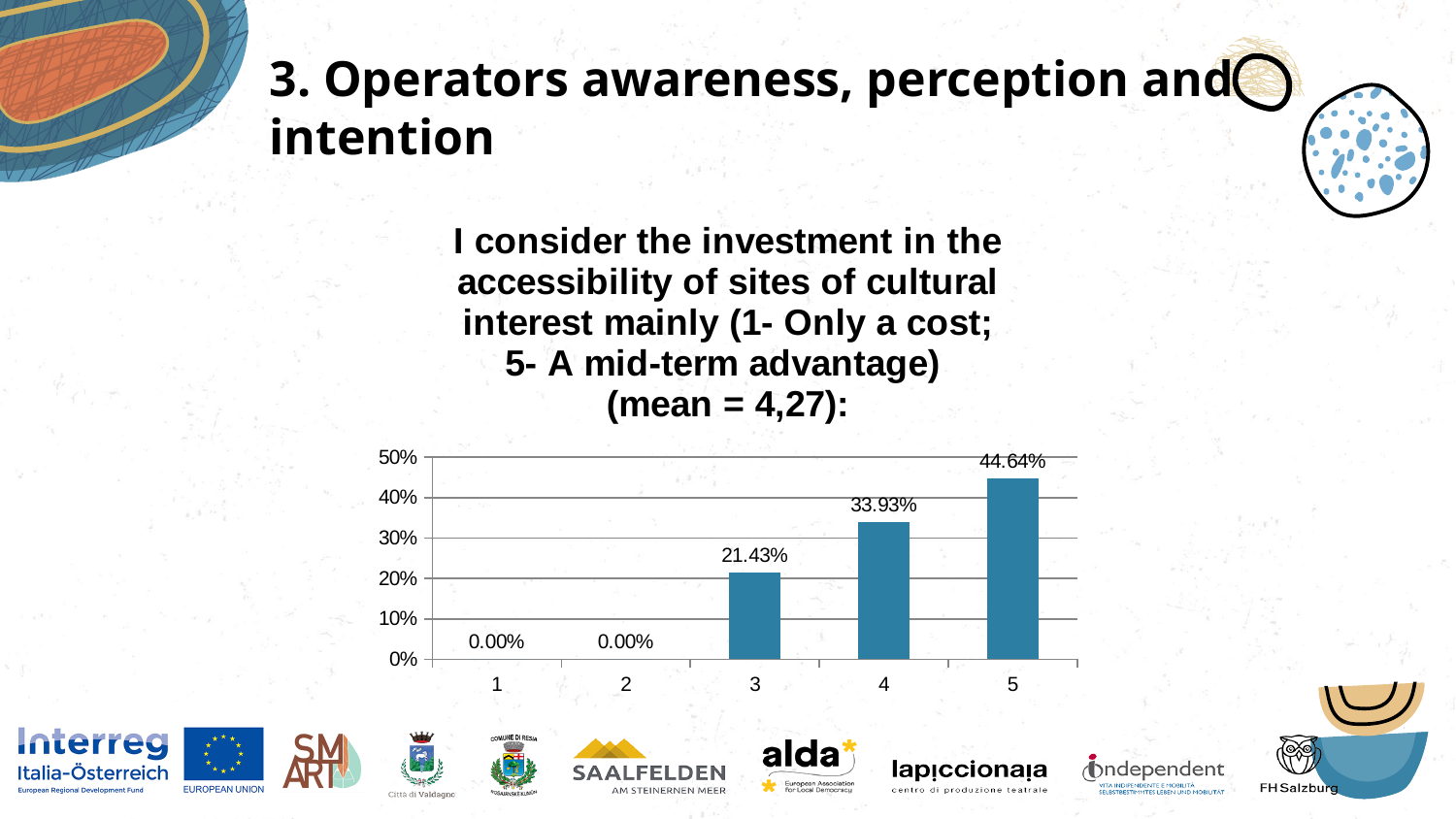
Which category has the highest value? 5 What kind of chart is shown on the slide? bar chart What is the value for category 5? 44.64% What is the difference between the values for category 5 and category 4? 10.71% Which is larger, the value for category 3 or the value for category 4? 4 What is the value for category 1? 0.00% Do the values rise or fall from category 1 to category 5? rise What is the value for category 3? 21.43% What is the difference between the values for category 4 and category 3? 12.50% How many categories are shown on the x axis? 5 Is the value for category 5 greater or less than 40%? greater What is the value for category 4? 33.93%